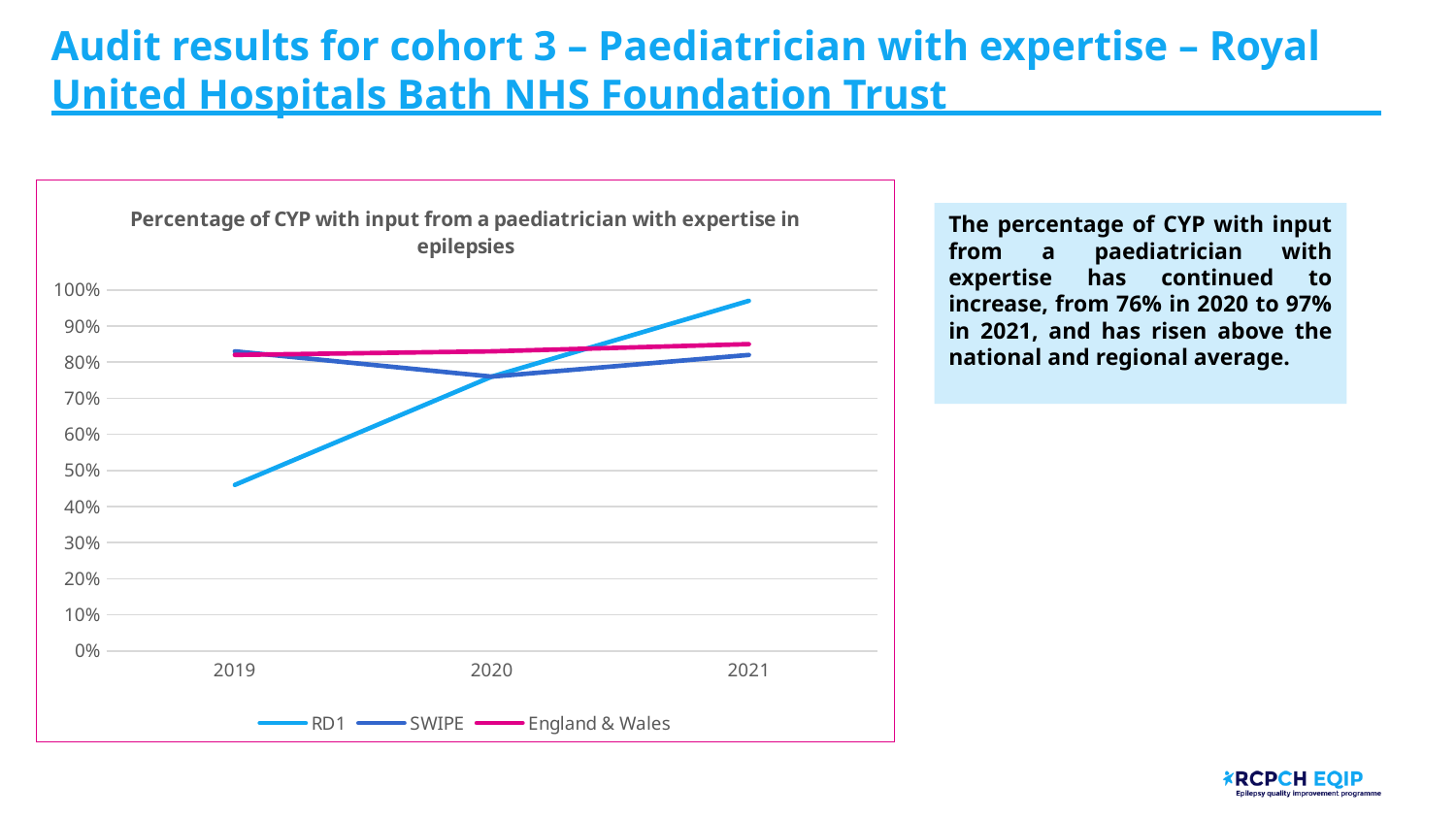
How many series does the chart legend list? 3 Which series has the highest value in 2021? RD1 What is the title of the chart? Percentage of CYP with input from a paediatrician with expertise in epilepsies Is the value for RD1 in 2021 greater or less than 90%? greater What kind of chart is shown on the slide? Line chart Is the value for RD1 in 2019 greater or less than 50%? less Which series is plotted with the pink line? England & Wales In 2021, which is larger: the RD1 value or the SWIPE value? RD1 How many years are shown on the x axis of the chart? 3 Is the value for England & Wales in 2021 greater or less than 80%? greater Does the RD1 line rise or fall from 2019 to 2021? Rises Which series has the lowest value in 2019? RD1